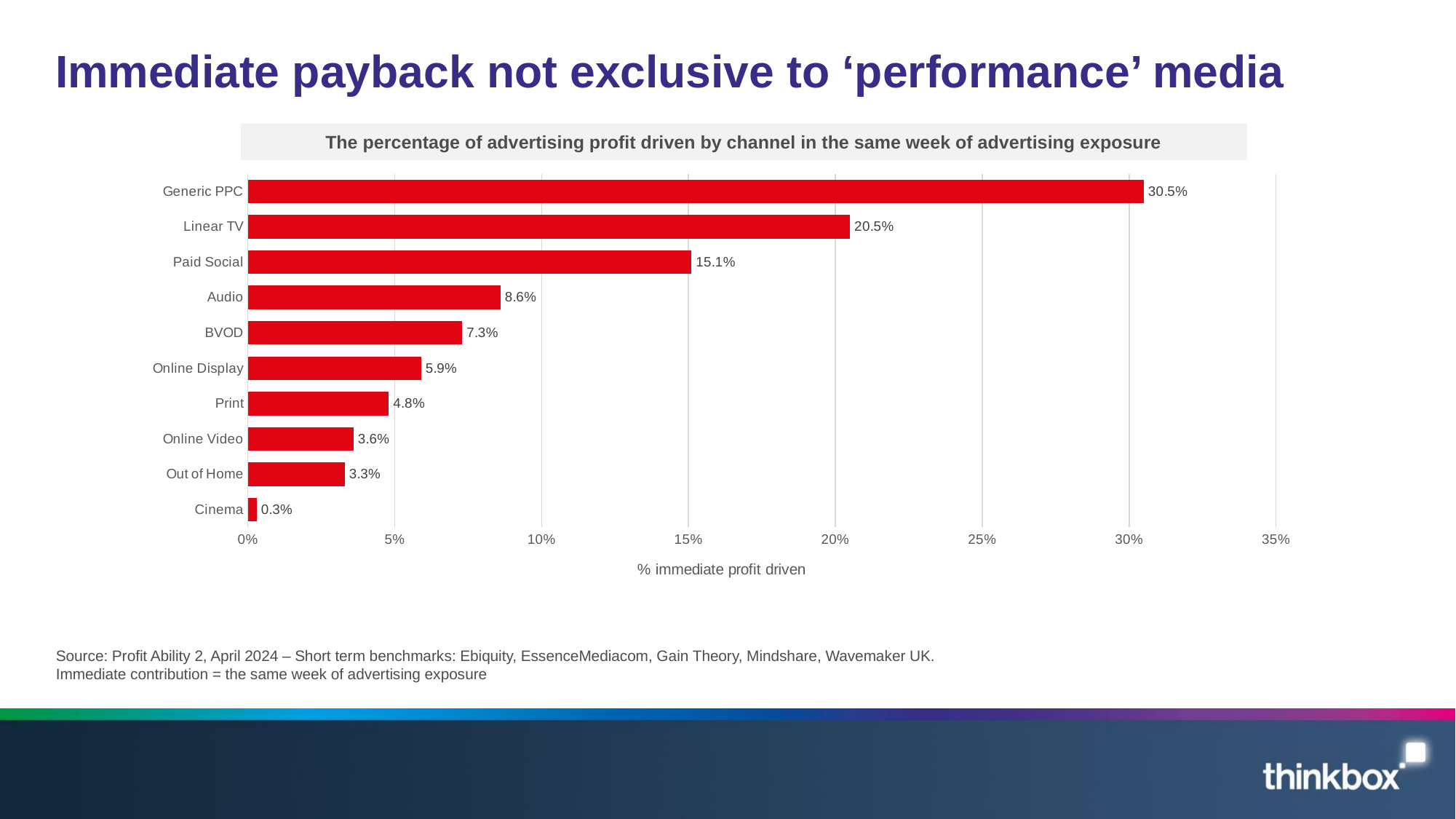
What is the value for Audio? 8.6% What is the difference between the values for Generic PPC and Linear TV? 10 percentage points How many channels are shown in the chart? 10 What kind of chart is shown on the slide? Bar chart Is the value for Paid Social greater or less than 10%? greater What is the difference between the values for Paid Social and BVOD? 7.8 percentage points Which channel has the lowest percentage of immediate profit driven? Cinema Which is larger, the value for Online Display or the value for Print? Online Display Which channel has the highest percentage of immediate profit driven? Generic PPC What is the value for Linear TV? 20.5% What is the value for Out of Home? 3.3% What is the label on the horizontal axis of the chart? % immediate profit driven